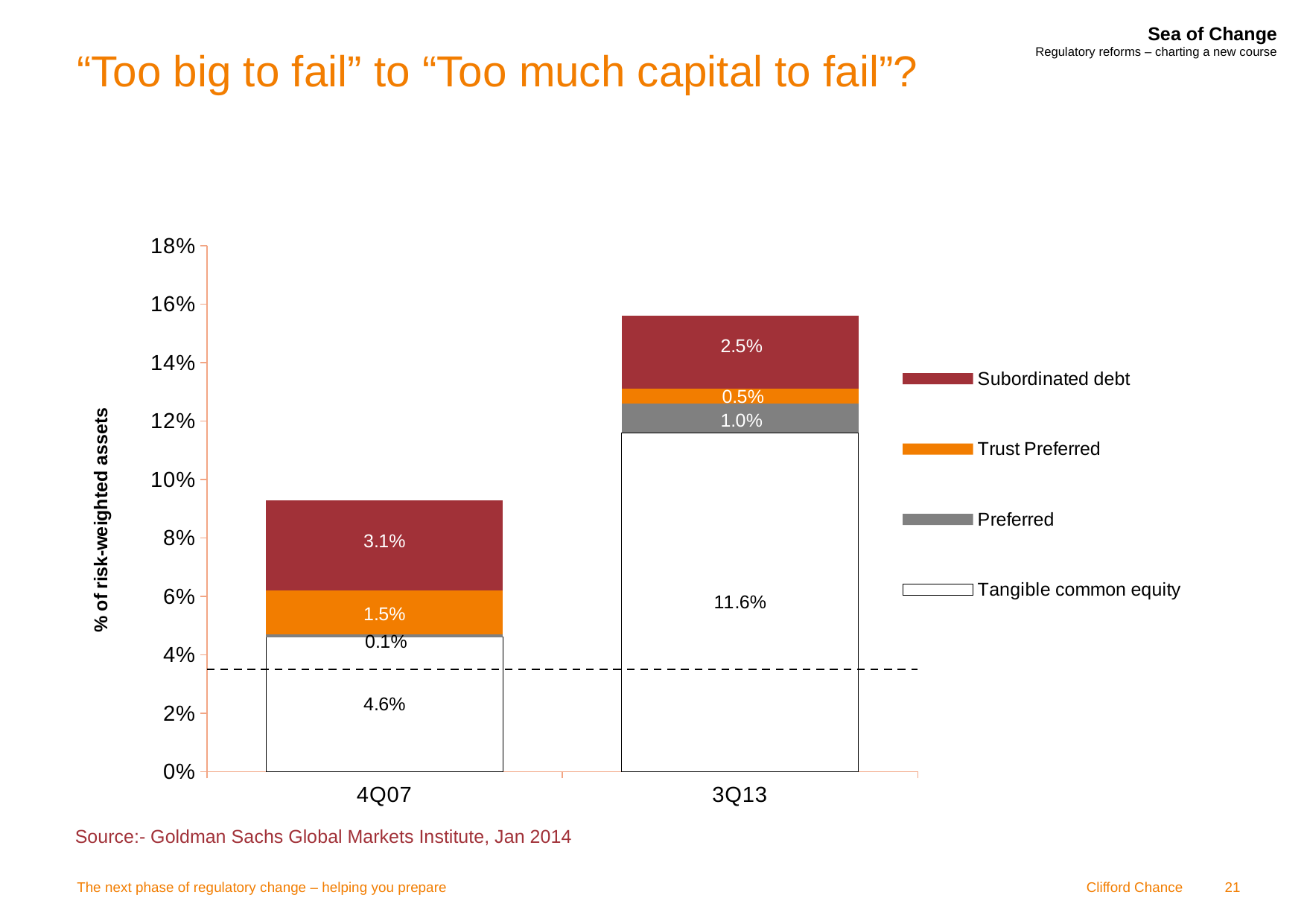
What is the value for Tangible common equity in 4Q07? 4.6% What kind of chart is shown on the slide? Stacked bar chart What is the value for Subordinated debt in 3Q13? 2.5% What is the label of the y axis? % of risk-weighted assets What is the difference between Tangible common equity in 3Q13 and in 4Q07? 7.0% What is the total of the stacked bar for 4Q07? 9.3% What is the total of the stacked bar for 3Q13? 15.6% How many categories are shown on the x axis? 2 What is the value for Trust Preferred in 4Q07? 1.5% Which is larger, Subordinated debt in 4Q07 or Subordinated debt in 3Q13? 4Q07 What is the value for Preferred in 3Q13? 1.0% How many series does the legend list? 4